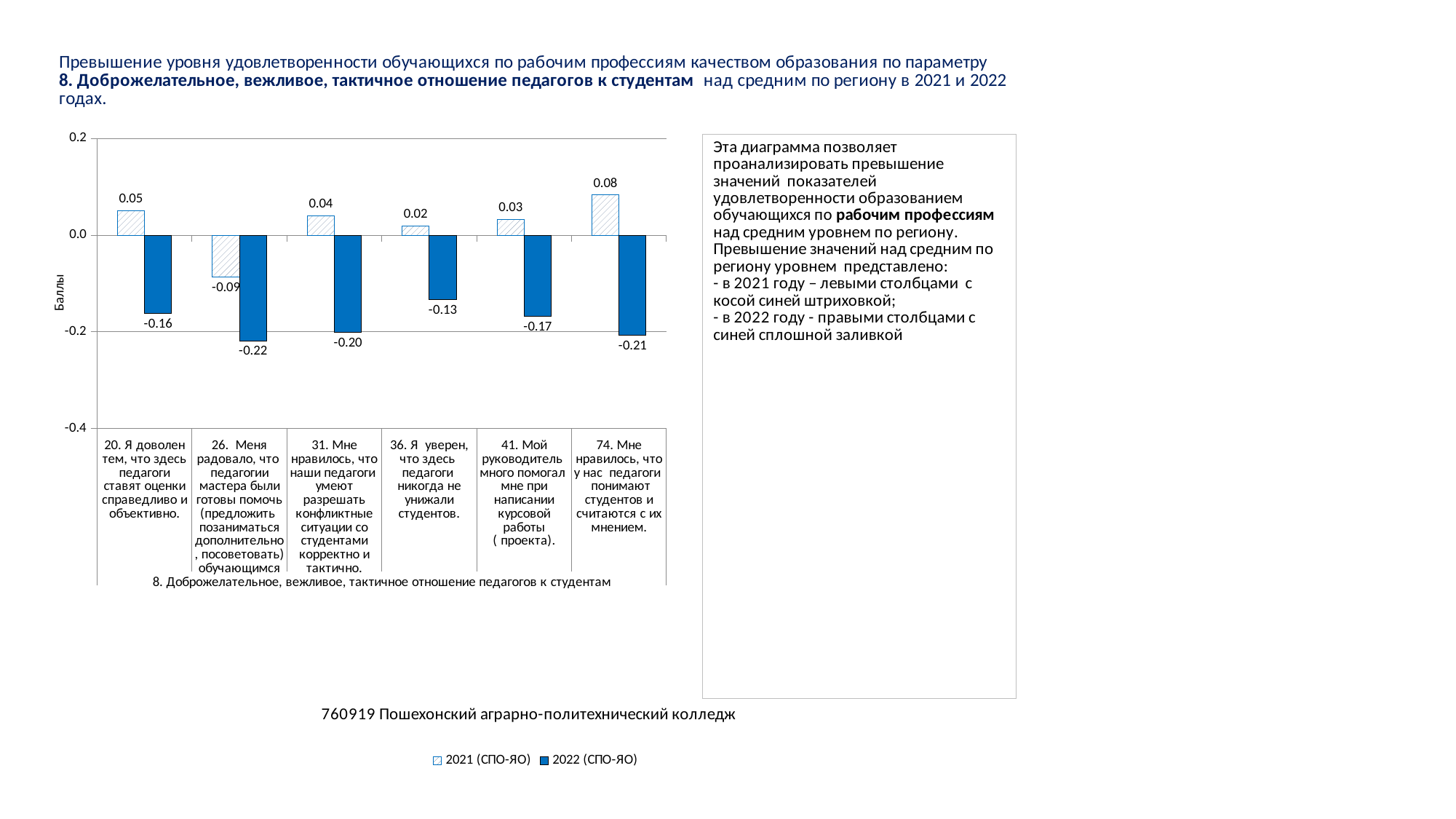
What is the 2022 (СПО-ЯО) value for category 26 ("Меня радовало, что педагоги мастера были готовы помочь...")? -0.22 Which category has the lowest 2021 (СПО-ЯО) value? 26. Меня радовало, что педагоги мастера были готовы помочь (предложить позаниматься дополнительно, посоветовать) обучающимся Which category has the lowest 2022 (СПО-ЯО) value? 26. Меня радовало, что педагоги мастера были готовы помочь (предложить позаниматься дополнительно, посоветовать) обучающимся How many categories are shown on the x axis? 6 Which category has the highest 2021 (СПО-ЯО) value? 74. Мне нравилось, что у нас педагоги понимают студентов и считаются с их мнением. What kind of chart is shown on the slide? Bar chart How many series does the legend list? 2 What is the 2022 (СПО-ЯО) value for category 36 ("Я уверен, что здесь педагоги никогда не унижали студентов")? -0.13 What is the difference between the 2021 and 2022 values for category 74 ("Мне нравилось, что у нас педагоги понимают студентов...")? 0.29 Which is larger: the 2022 value for category 36 or the 2022 value for category 41? Category 36 (-0.13) What is the label of the vertical axis? Баллы What is the 2021 (СПО-ЯО) value for category 20 ("Я доволен тем, что здесь педагоги ставят оценки справедливо и объективно")? 0.05